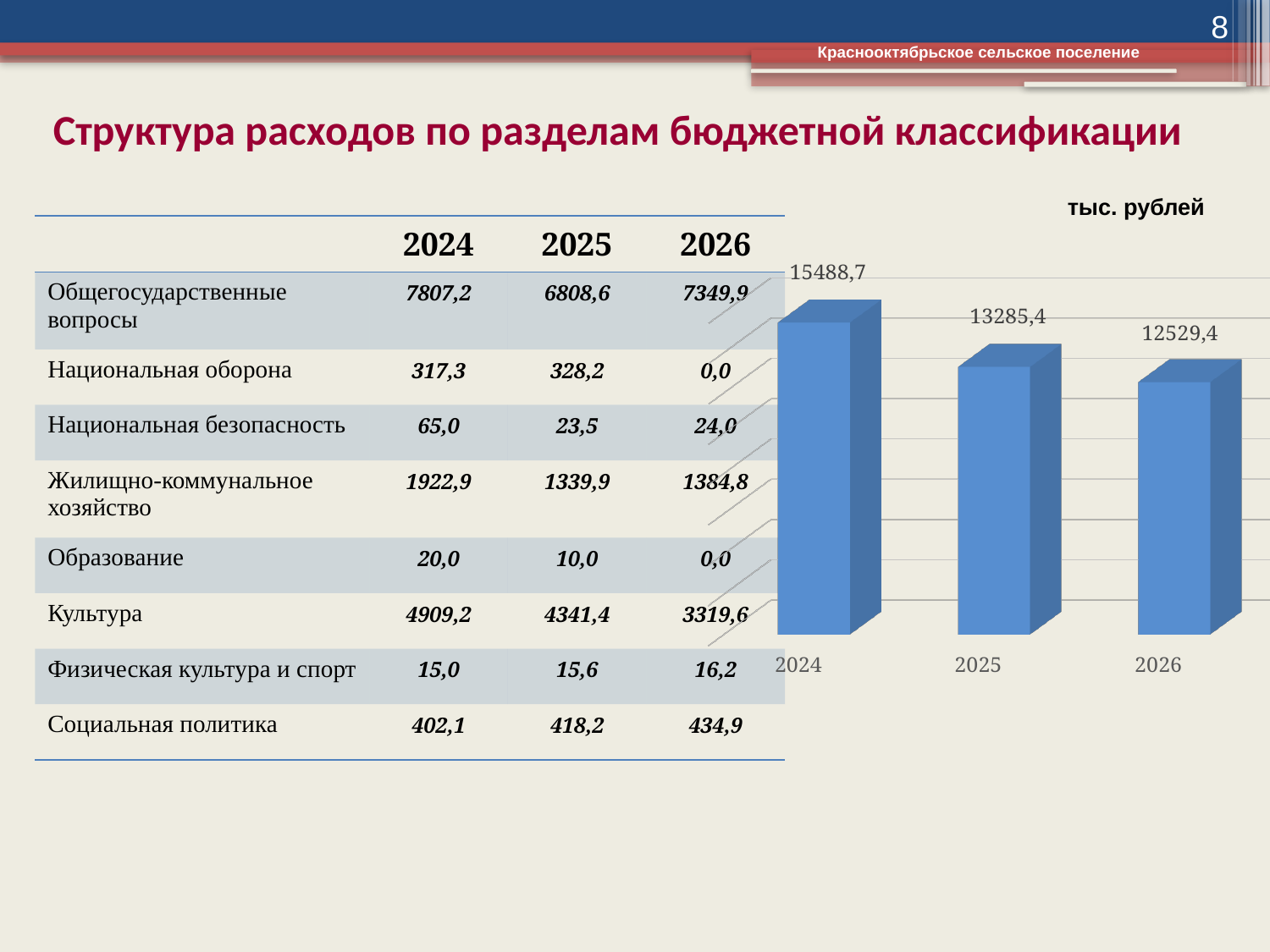
What is the difference between the 2025 and 2026 values on the chart? 756,0 Which is larger on the chart, the value for 2025 or the value for 2026? 2025 What kind of chart is shown on the slide? bar chart What is the value shown for 2024 on the chart? 15488,7 Do the values on the chart rise or fall from 2024 to 2026? fall What is the difference between the 2024 and 2026 values on the chart? 2959,3 What is the value shown for 2026 on the chart? 12529,4 What is the value shown for 2025 on the chart? 13285,4 Which year has the lowest value on the chart? 2026 What is the difference between the 2024 and 2025 values on the chart? 2203,3 How many bars are plotted on the chart? 3 Which year has the highest value on the chart? 2024